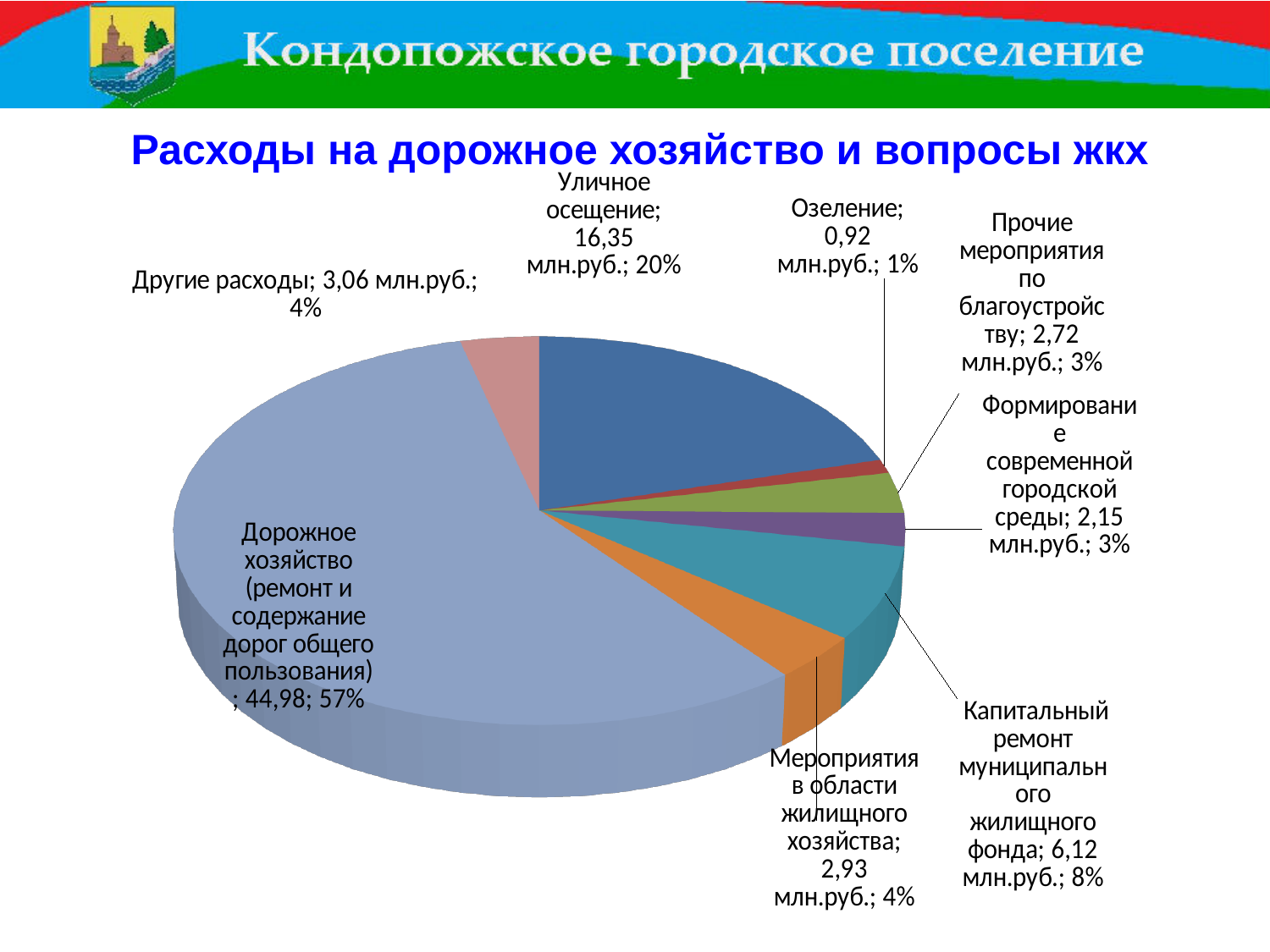
What is the value for Капитальный ремонт муниципального жилищного фонда? 6,12 млн.руб. Which category has the largest slice? Дорожное хозяйство (ремонт и содержание дорог общего пользования) What share of the pie does Озеленение take? 1% What is the title of the chart? Расходы на дорожное хозяйство и вопросы жкх What share of the pie does Дорожное хозяйство (ремонт и содержание дорог общего пользования) take? 57% How many slices does the pie chart have? 8 What is the difference between the values for Уличное освещение and Капитальный ремонт муниципального жилищного фонда? 10,23 млн.руб. What is the value for Уличное освещение? 16,35 млн.руб. Which category has the smallest slice? Озеление Which is larger: Мероприятия в области жилищного хозяйства or Формирование современной городской среды? Мероприятия в области жилищного хозяйства What is the value for Другие расходы? 3,06 млн.руб. What kind of chart is shown on the slide? Pie chart